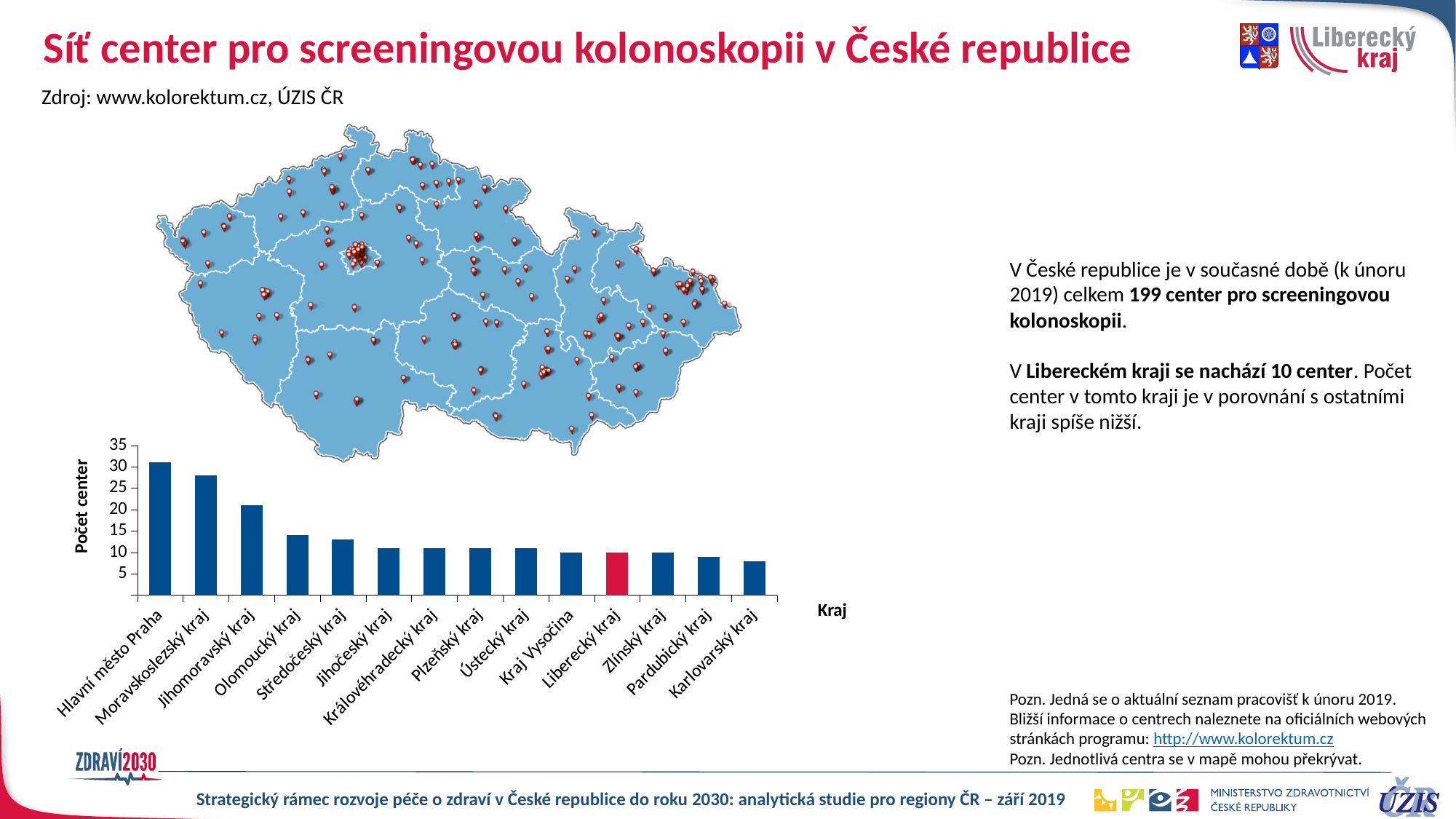
Which region has the lowest number of centers in the bar chart? Karlovarský kraj What kind of chart is shown at the bottom left of the slide? bar chart Which region's bar is highlighted in red in the bar chart? Liberecký kraj Is the value for Jihomoravský kraj greater or less than 20? greater Which has more centers, Jihomoravský kraj or Olomoucký kraj? Jihomoravský kraj How many regions (kraje) are shown on the x axis of the bar chart? 14 Is the value for Hlavní město Praha greater or less than 30? greater Do the bar values rise or fall from left to right along the x axis? fall Is the value for Karlovarský kraj greater or less than 10? less How many screening colonoscopy centers does Liberecký kraj have according to the slide? 10 Which region has the highest number of centers in the bar chart? Hlavní město Praha